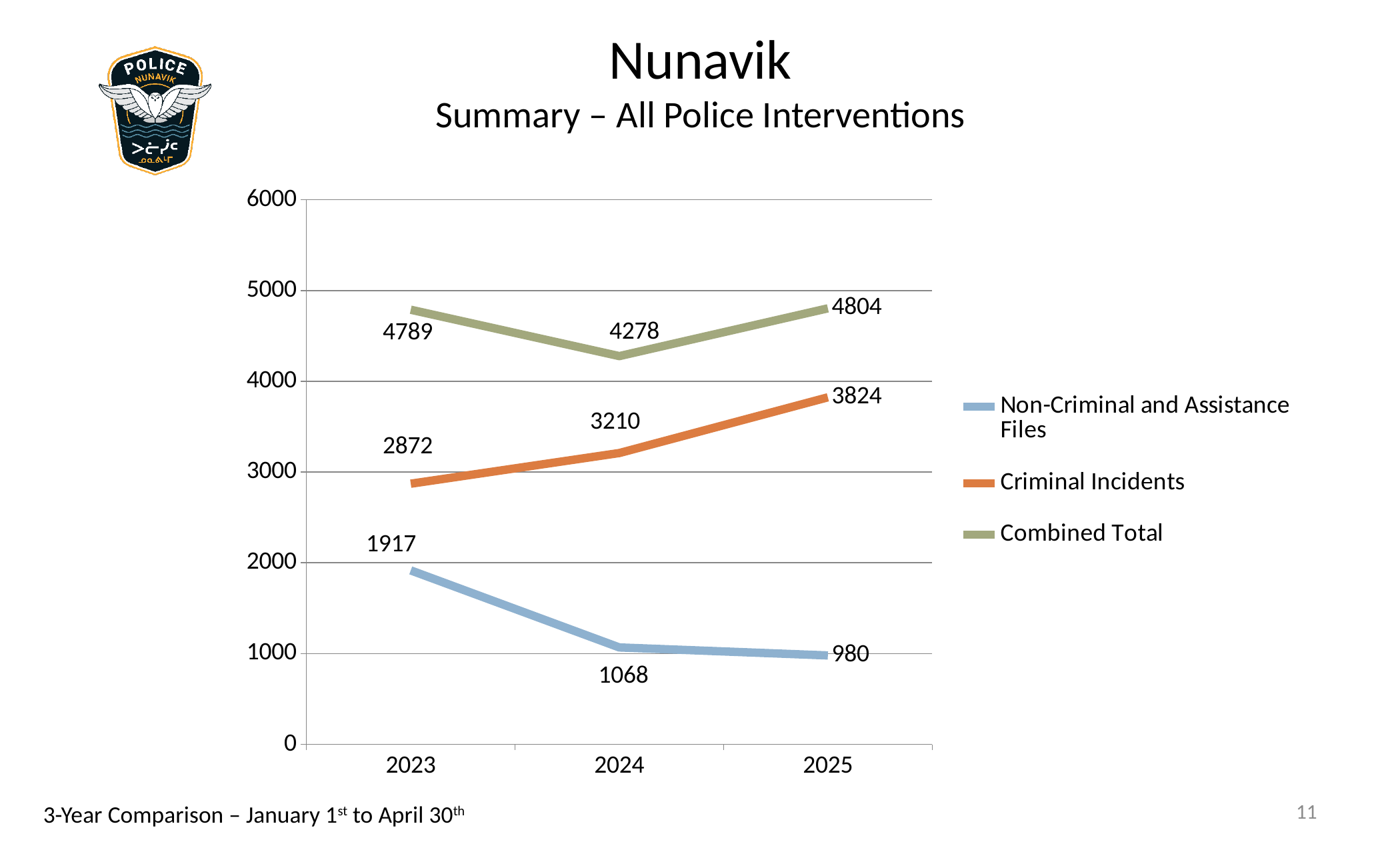
What is the value for Criminal Incidents in 2024? 3210 How many years are shown on the x axis? 3 What is the value for Non-Criminal and Assistance Files in 2023? 1917 Do the values for Non-Criminal and Assistance Files rise or fall from 2023 to 2025? fall What kind of chart is shown on the slide? line chart In which year are Criminal Incidents highest? 2025 In which year is the Combined Total lowest? 2024 What is the difference between Criminal Incidents in 2025 and 2023? 952 What is the Combined Total for 2025? 4804 Is the value for Criminal Incidents in 2023 greater or less than 3000? less Which is larger: Non-Criminal and Assistance Files in 2024 or in 2025? 2024 How many series does the legend list? 3